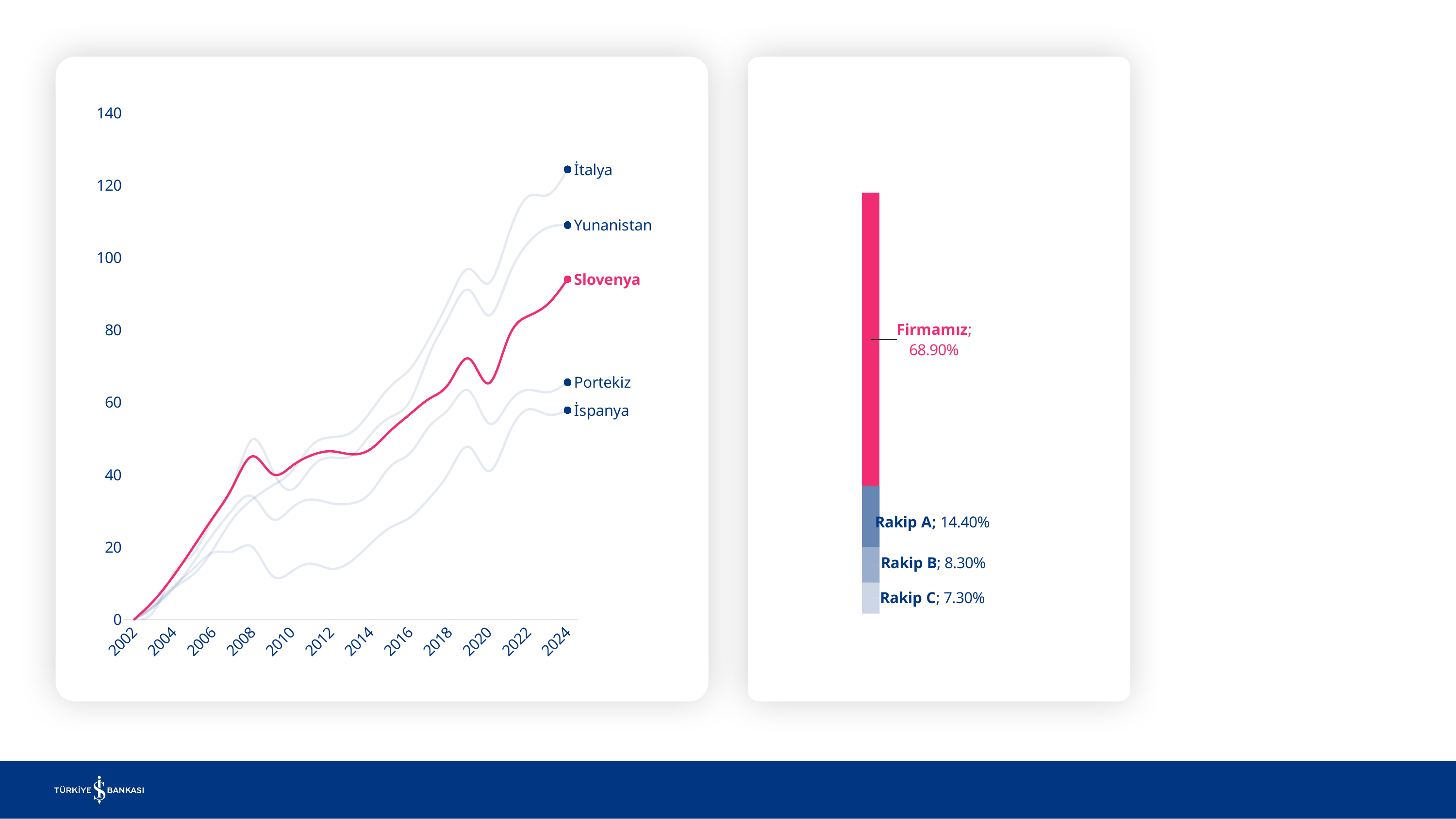
On the left chart, is the value for İspanya in 2024 greater or less than 60? less On the right chart, what is the total of the stacked bar? 98.90% On the left chart, is the value for İtalya in 2024 greater or less than 120? greater On the right chart, what is the value for Firmamız? 68.90% On the left chart, which series has the lowest value in 2024? İspanya On the left chart, is the value for Slovenya in 2024 greater or less than 100? less On the left chart, which is larger in 2024, Yunanistan or Portekiz? Yunanistan On the left chart, do the values for Slovenya generally rise or fall from 2002 to 2024? rise How many series are labelled on the left chart? 5 On the right chart, what is the difference between Firmamız and Rakip A? 54.50% On the left chart, which series has the highest value in 2024? İtalya What kind of chart is the left chart? line chart